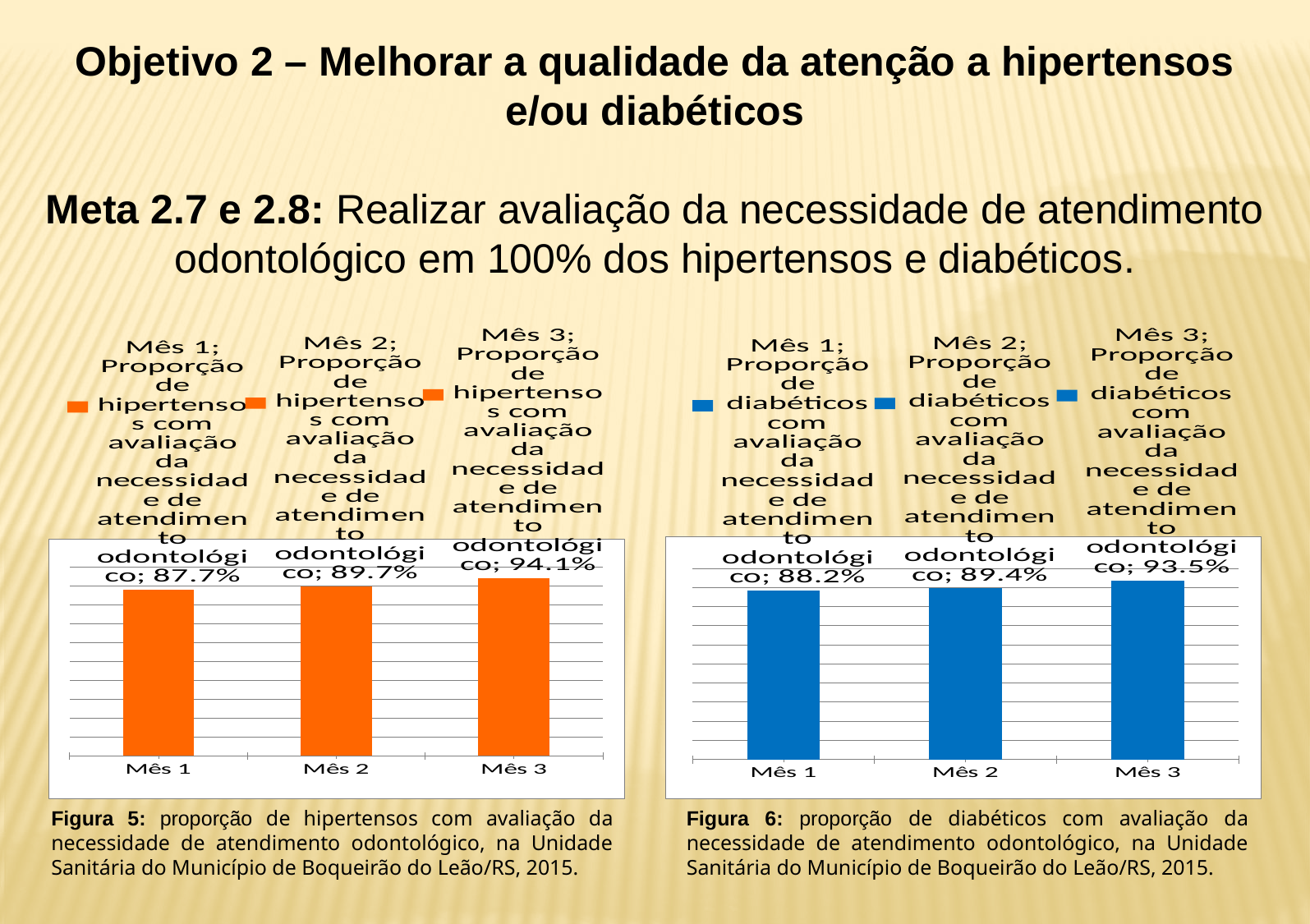
In the left chart (Figura 5, hipertensos), what is the value for Mês 1? 87.7% In the right chart (Figura 6, diabéticos), what is the value for Mês 2? 89.4% Which is larger: the Mês 2 value in the left chart (hipertensos) or the Mês 2 value in the right chart (diabéticos)? Left chart (hipertensos), 89.7% In the right chart (Figura 6, diabéticos), do the values rise or fall from Mês 1 to Mês 3? Rise In the right chart (Figura 6, diabéticos), which month has the lowest value? Mês 1 What kind of chart is the left chart (Figura 5, hipertensos)? Bar chart In the right chart (Figura 6, diabéticos), what is the value for Mês 3? 93.5% How many months (categories) are plotted in the right chart (Figura 6, diabéticos)? 3 In the left chart (Figura 5, hipertensos), what is the difference between the values for Mês 3 and Mês 1? 6.4% In the left chart (Figura 5, hipertensos), which month has the highest value? Mês 3 In the right chart (Figura 6, diabéticos), what is the difference between the values for Mês 3 and Mês 2? 4.1% In the left chart (Figura 5, hipertensos), what is the value for Mês 3? 94.1%